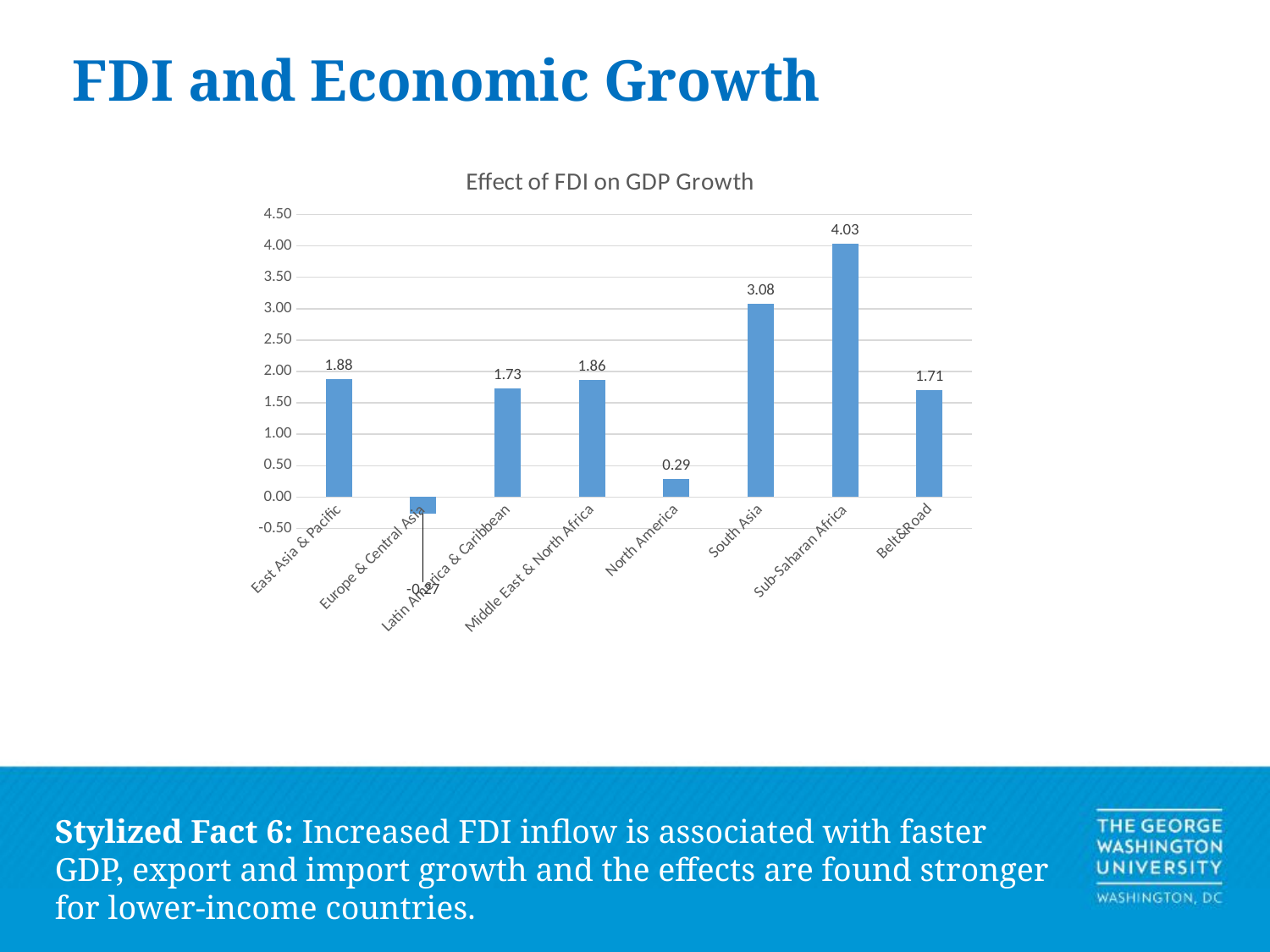
Is the value for Europe & Central Asia greater or less than 0.00? less What is the title of the chart? Effect of FDI on GDP Growth What is the difference between the values for Sub-Saharan Africa and South Asia? 0.95 What is the value for Sub-Saharan Africa in the Effect of FDI on GDP Growth chart? 4.03 Which region has the lowest effect of FDI on GDP growth? Europe & Central Asia How many regions are shown in the chart? 8 What kind of chart is shown on the slide? bar chart What is the value for Belt&Road? 1.71 Which is larger, the value for South Asia or the value for Belt&Road? South Asia What is the value for South Asia? 3.08 What is the value for North America? 0.29 Which region has the highest effect of FDI on GDP growth? Sub-Saharan Africa